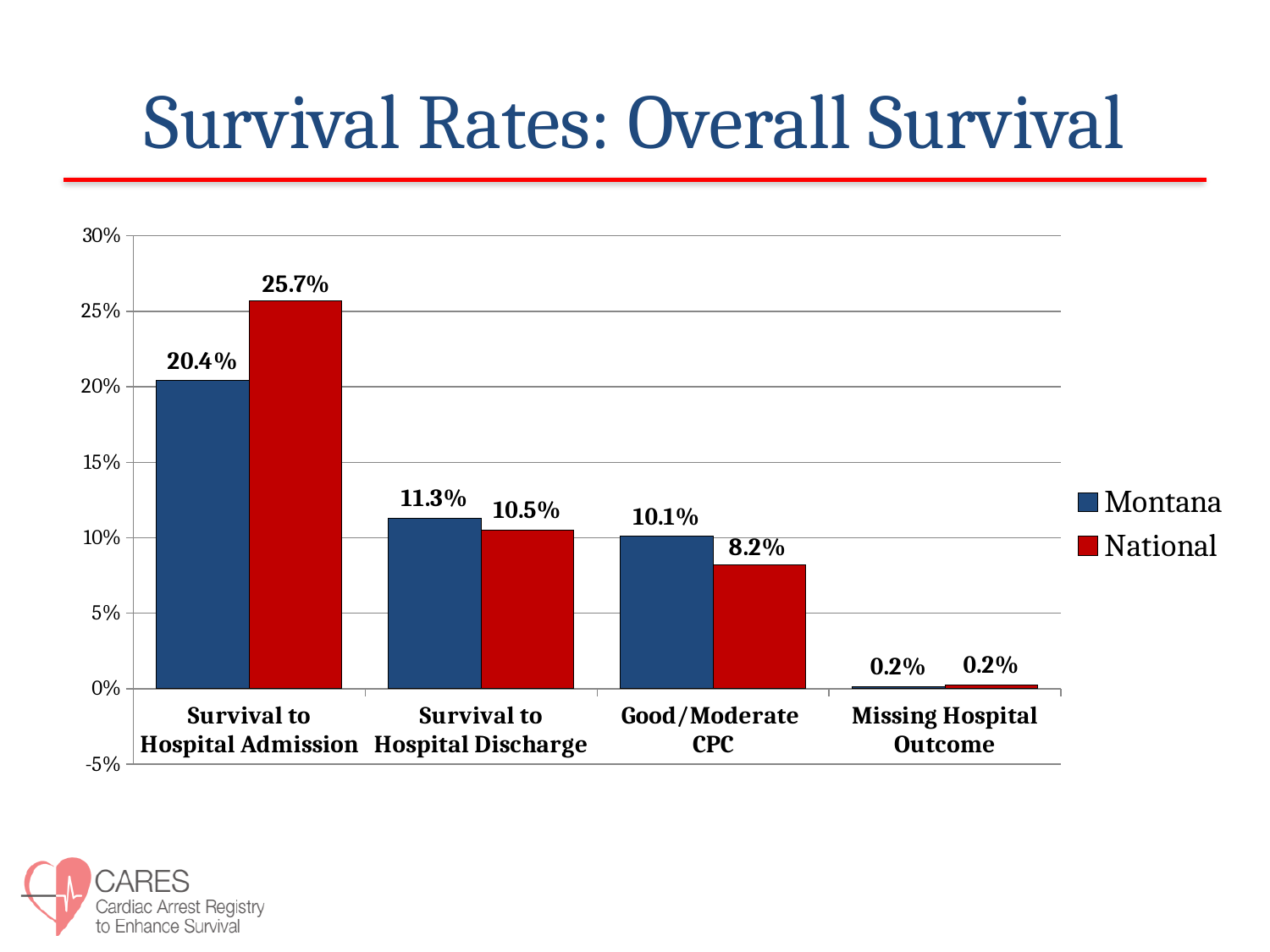
What is the National value for Survival to Hospital Discharge? 10.5% Which category has the lowest Montana value? Missing Hospital Outcome Which colour represents National in the chart? Red What kind of chart is shown on the slide? Bar chart How many series does the legend list? 2 What is the difference between the Montana and National values for Good/Moderate CPC? 1.9% How many categories are shown on the x axis? 4 What is the National value for Good/Moderate CPC? 8.2% What is the Montana value for Survival to Hospital Admission? 20.4% Which category has the highest National value? Survival to Hospital Admission What is the difference between the National and Montana values for Survival to Hospital Admission? 5.3% For Survival to Hospital Discharge, which is larger, Montana or National? Montana